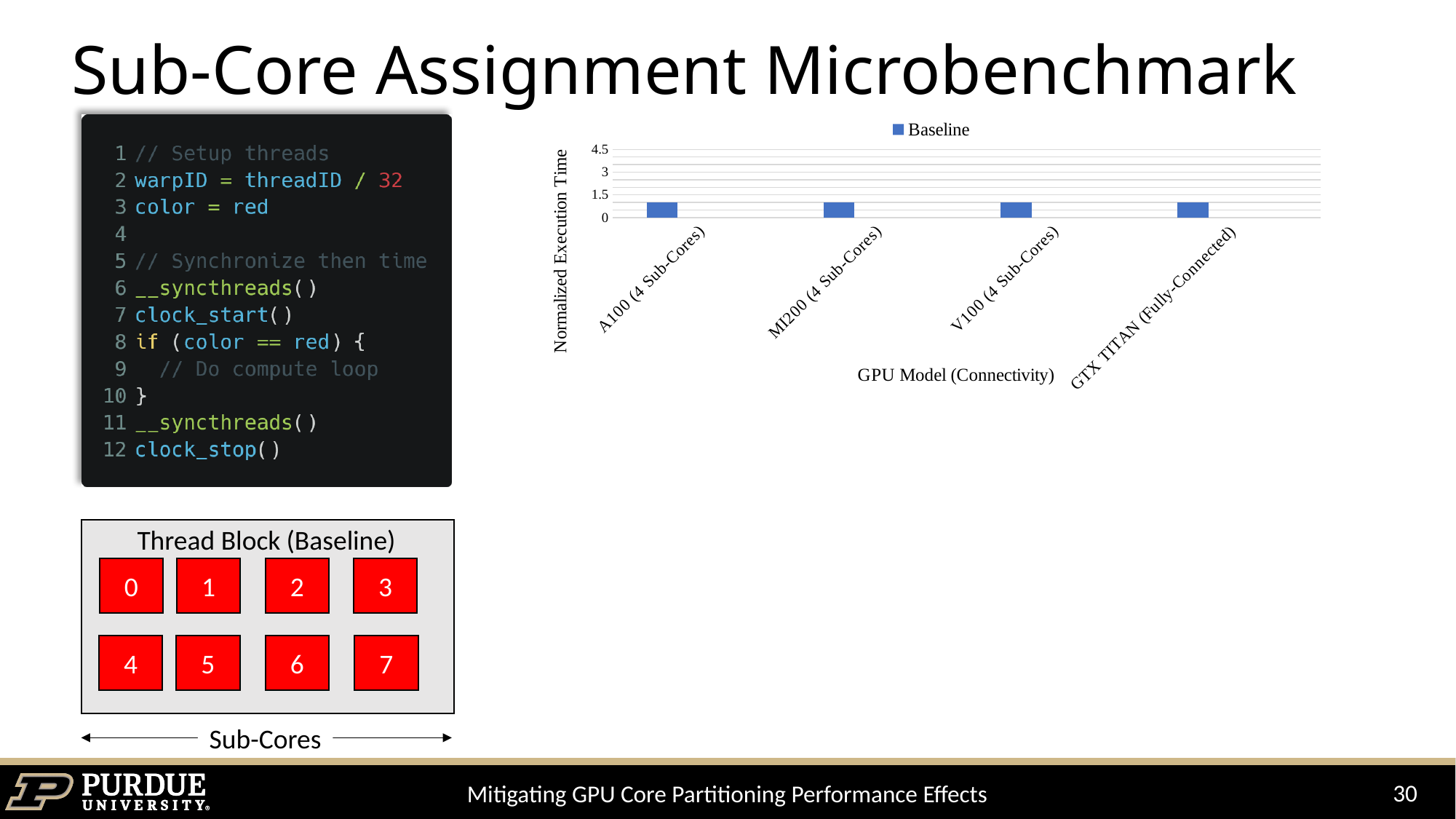
What is the title of the chart's y axis? Normalized Execution Time What kind of chart is shown on the slide? bar chart Is the normalized execution time for MI200 (4 Sub-Cores) greater or less than 1.5? less Is the normalized execution time for V100 (4 Sub-Cores) greater or less than 1.5? less What series name is shown in the chart's legend? Baseline Which GPU model on the x axis is labeled as Fully-Connected rather than 4 Sub-Cores? GTX TITAN How many series does the chart's legend list? 1 Do the bar values rise, fall, or stay roughly flat across the GPU models along the x axis? stay roughly flat How many GPU model categories are plotted on the x axis of the chart? 4 Is the normalized execution time for A100 (4 Sub-Cores) greater or less than 1.5? less